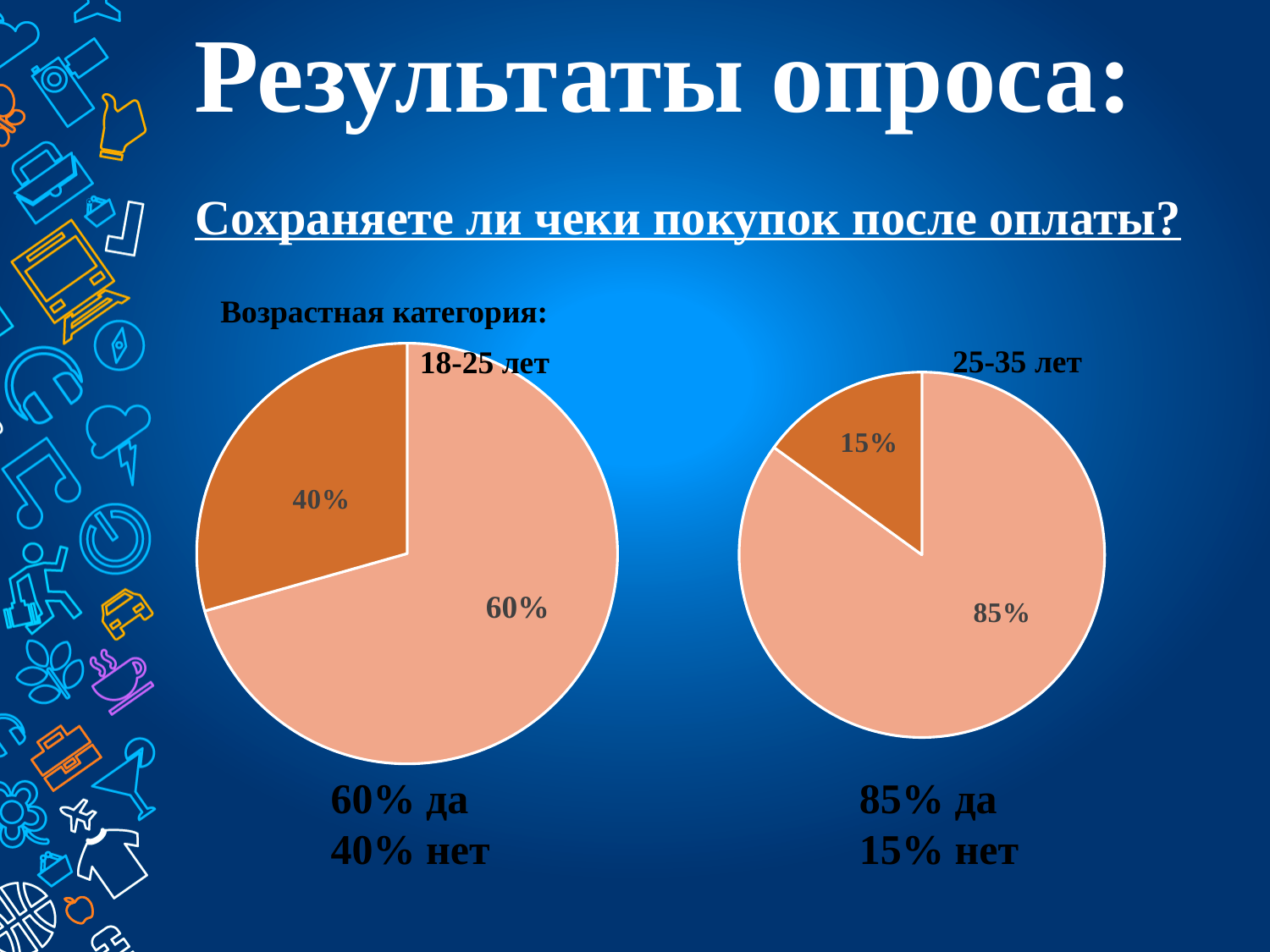
Which age group has the larger "нет" share, 18-25 лет or 25-35 лет? 18-25 лет In the pie chart for 18-25 лет, what share of respondents answered "да"? 60% What is the difference between the "да" share for 25-35 лет and the "да" share for 18-25 лет? 25% In the pie chart for 18-25 лет, what share of respondents answered "нет"? 40% How many pie charts are shown on the slide? 2 What type of chart is used for the 25-35 лет age group? Pie chart In the pie chart for 25-35 лет, which answer has the largest slice? да In the pie chart for 25-35 лет, what share of respondents answered "нет"? 15% What survey question is shown above the charts? Сохраняете ли чеки покупок после оплаты? In the pie chart for 25-35 лет, what share of respondents answered "да"? 85% How many slices does the pie chart for 18-25 лет have? 2 In the pie chart for 18-25 лет, which answer has the smallest slice? нет